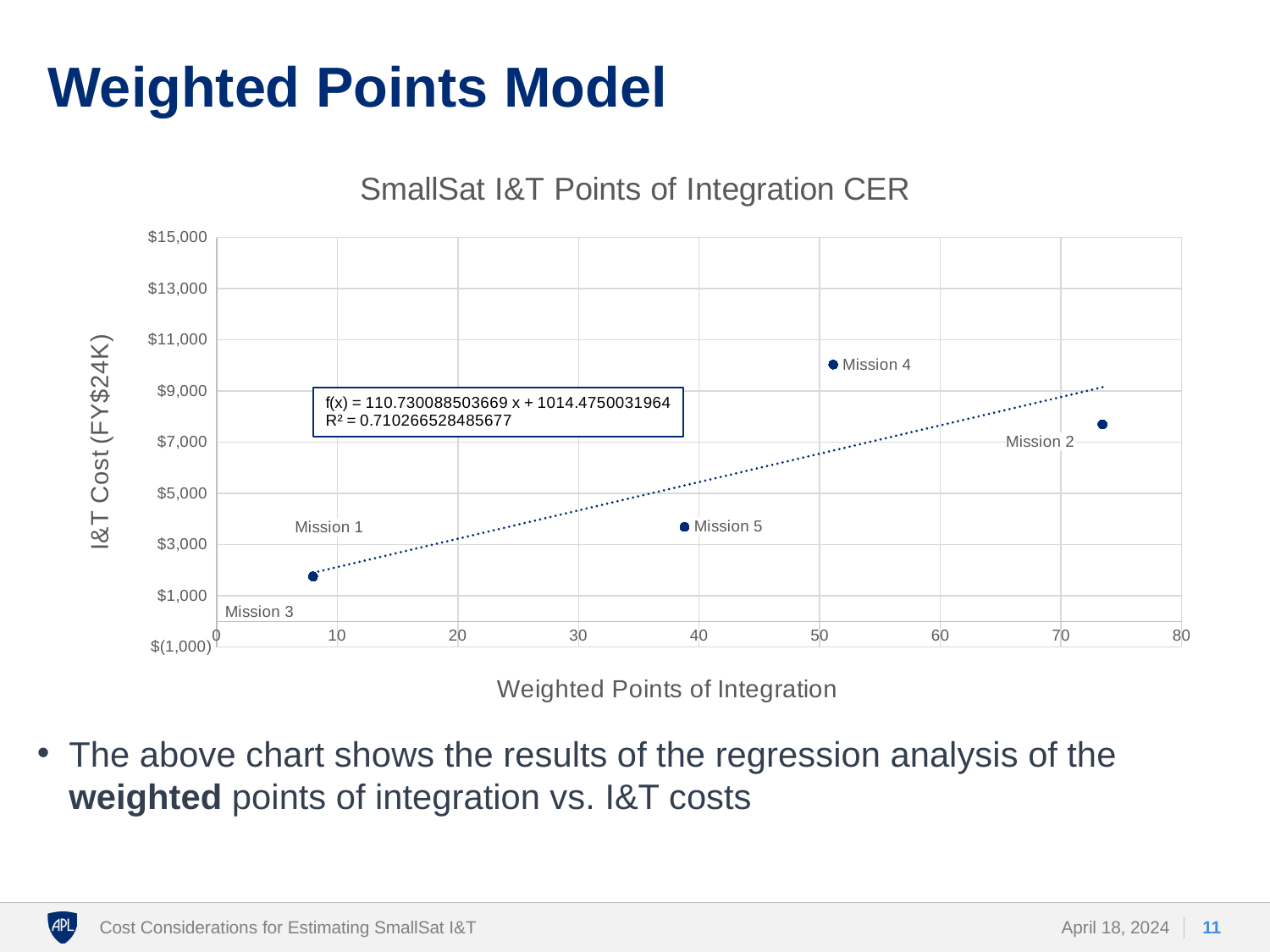
What is the label of the y axis of the chart? I&T Cost (FY$24K) What is the title of the chart? SmallSat I&T Points of Integration CER Which mission has the highest I&T cost on the chart? Mission 4 Which has the higher I&T cost, Mission 4 or Mission 2? Mission 4 Which has the higher I&T cost, Mission 2 or Mission 5? Mission 2 What kind of chart is shown on the slide? Scatter chart What R² value is printed on the chart? 0.710266528485677 Is the I&T cost for Mission 4 greater or less than $9,000? greater Does the dotted trendline rise or fall as weighted points of integration increase? Rises Is the I&T cost for Mission 5 greater or less than $5,000? less Is the weighted points of integration value for Mission 2 greater or less than 70? greater What is the trendline equation printed on the chart? f(x) = 110.730088503669 x + 1014.4750031964